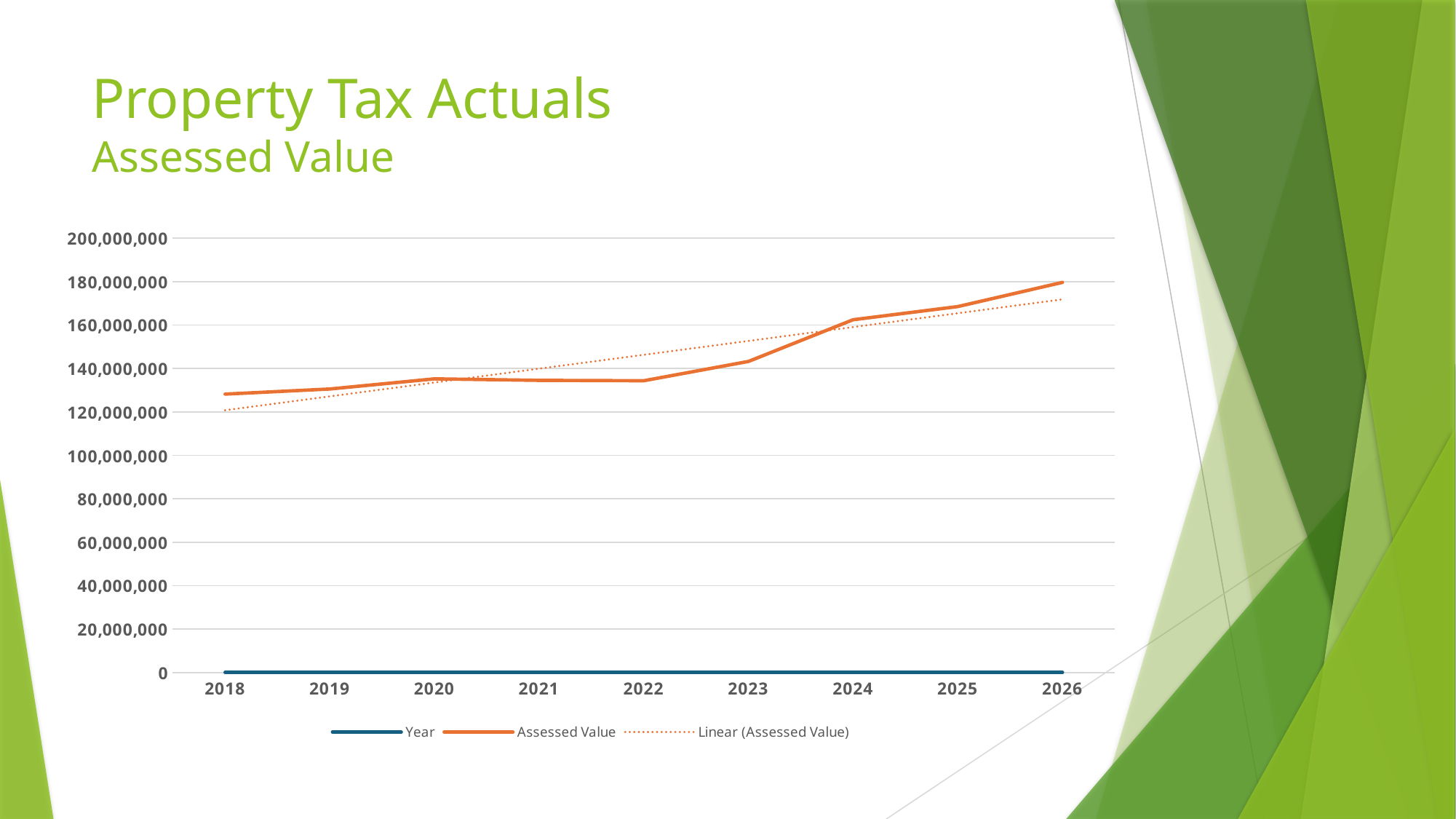
Is the Assessed Value for 2026 greater or less than 160,000,000? greater Is the Assessed Value for 2023 greater or less than 160,000,000? less Does the Assessed Value generally rise or fall from 2018 to 2026? Rise Which year has the lowest Assessed Value? 2018 How many years are plotted along the x axis? 9 Which year has the highest Assessed Value? 2026 Is the Assessed Value for 2022 greater or less than 140,000,000? less How many series does the legend list? 3 What kind of chart is shown on the slide? Line chart What is the name of the dotted series in the legend? Linear (Assessed Value) Which year has a larger Assessed Value, 2018 or 2026? 2026